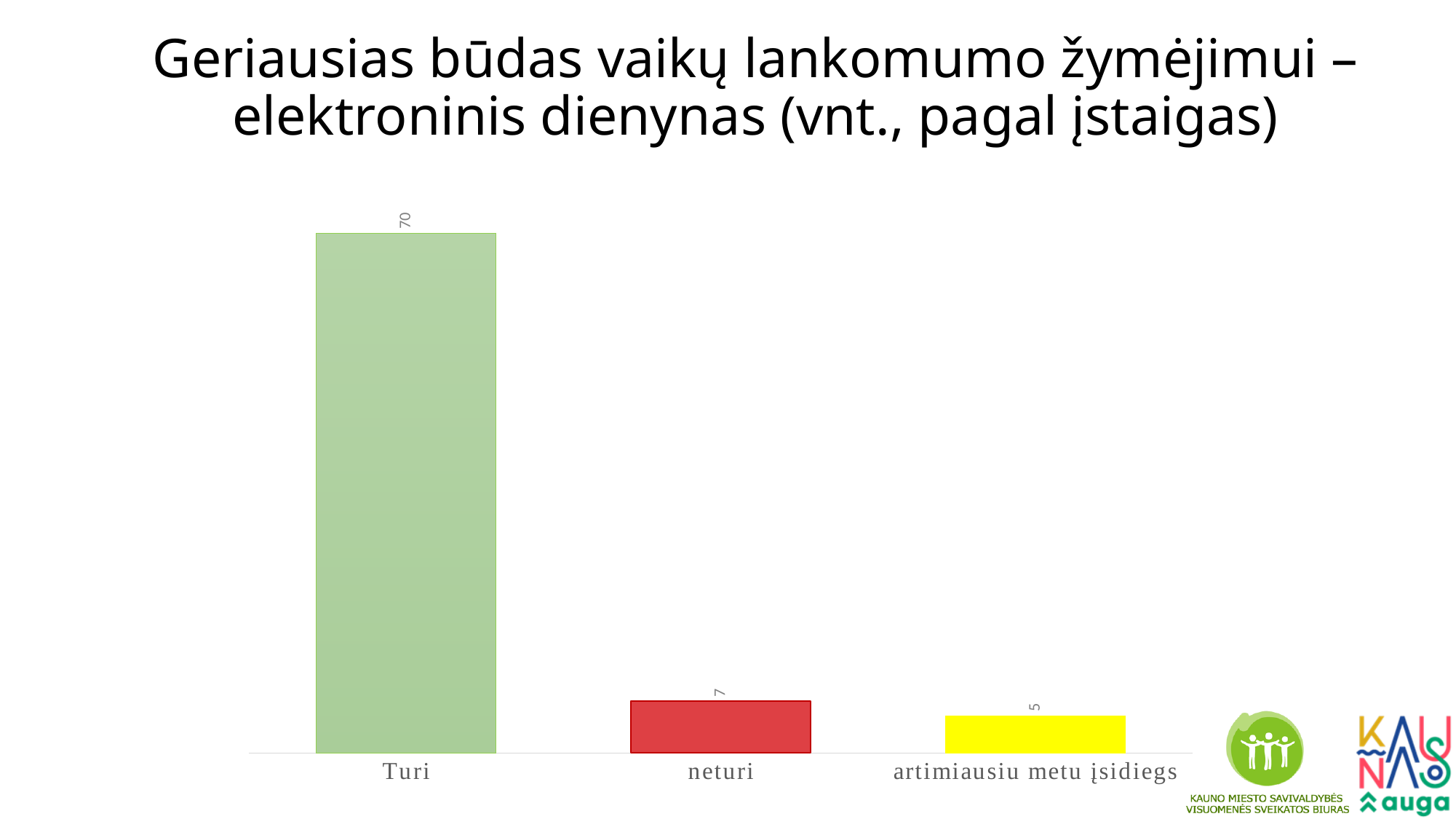
What kind of chart is shown on the slide? bar chart Which category has the lowest value? artimiausiu metu įsidiegs Which is larger, the value for neturi or the value for artimiausiu metu įsidiegs? neturi What is the difference between the values for neturi and artimiausiu metu įsidiegs? 2 Which category has the highest value? Turi What is the value for artimiausiu metu įsidiegs? 5 How many categories are shown on the x axis? 3 What is the value for Turi? 70 Do the values rise or fall from left to right along the x axis? fall What is the value for neturi? 7 What colour is the bar for neturi? red What is the difference between the values for Turi and neturi? 63